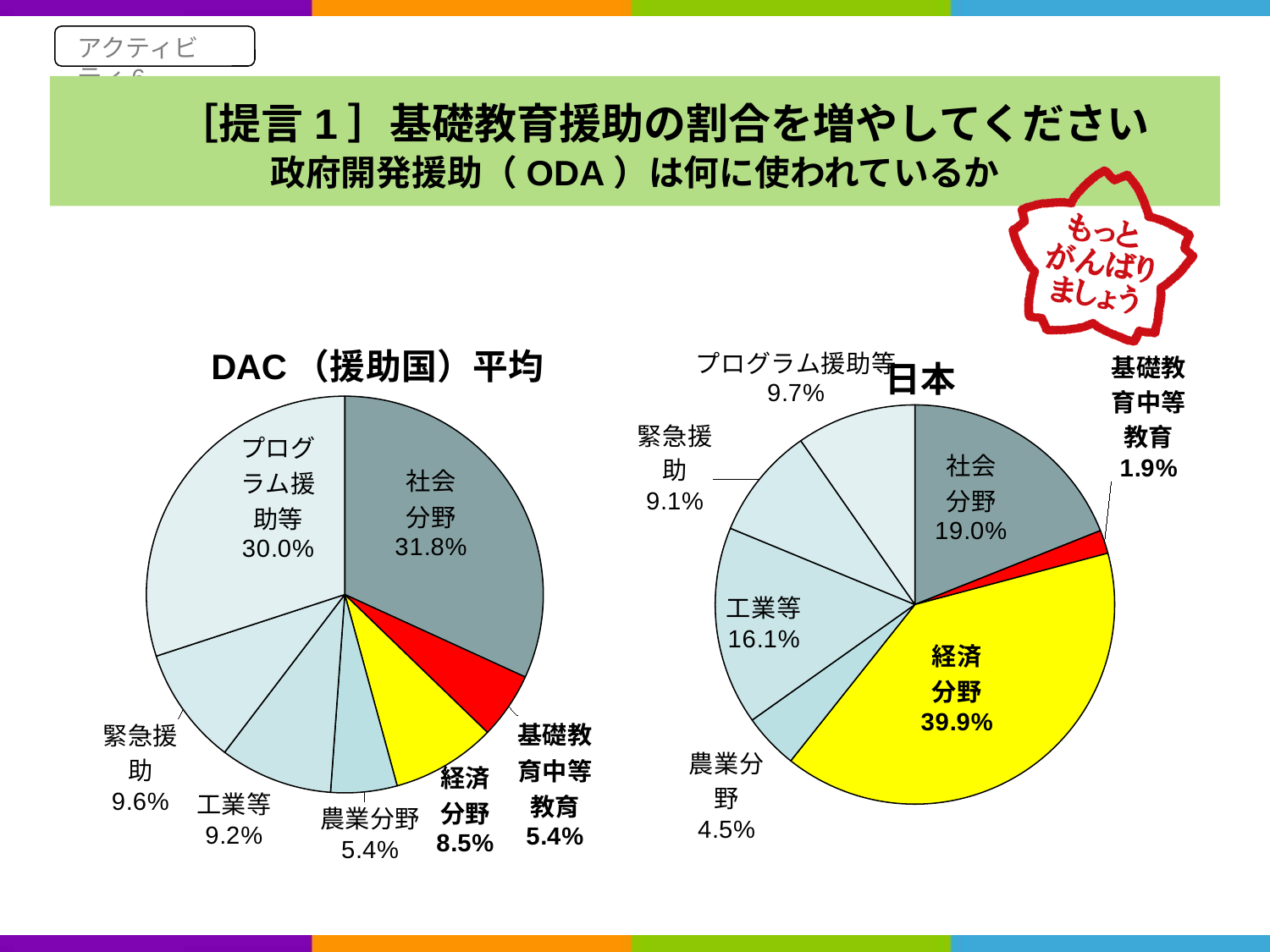
In the DAC（援助国）平均 pie chart, what share does プログラム援助等 have? 30.0% What type of chart is used for 日本? Pie chart In the DAC（援助国）平均 pie chart, how many categories are shown? 7 In the DAC（援助国）平均 pie chart, which category has the largest share? 社会分野 Which is larger: the 工業等 share in the DAC（援助国）平均 chart or in the 日本 chart? 日本 In the DAC（援助国）平均 pie chart, what share does 社会分野 have? 31.8% What is the difference between the 基礎教育中等教育 share in the DAC（援助国）平均 chart and in the 日本 chart? 3.5% In the 日本 pie chart, what colour is the 経済分野 slice? Yellow In the 日本 pie chart, which category has the largest share? 経済分野 In the 日本 pie chart, what share does 経済分野 have? 39.9% In the 日本 pie chart, which category has the smallest share? 基礎教育中等教育 In the 日本 pie chart, what share does 基礎教育中等教育 have? 1.9%